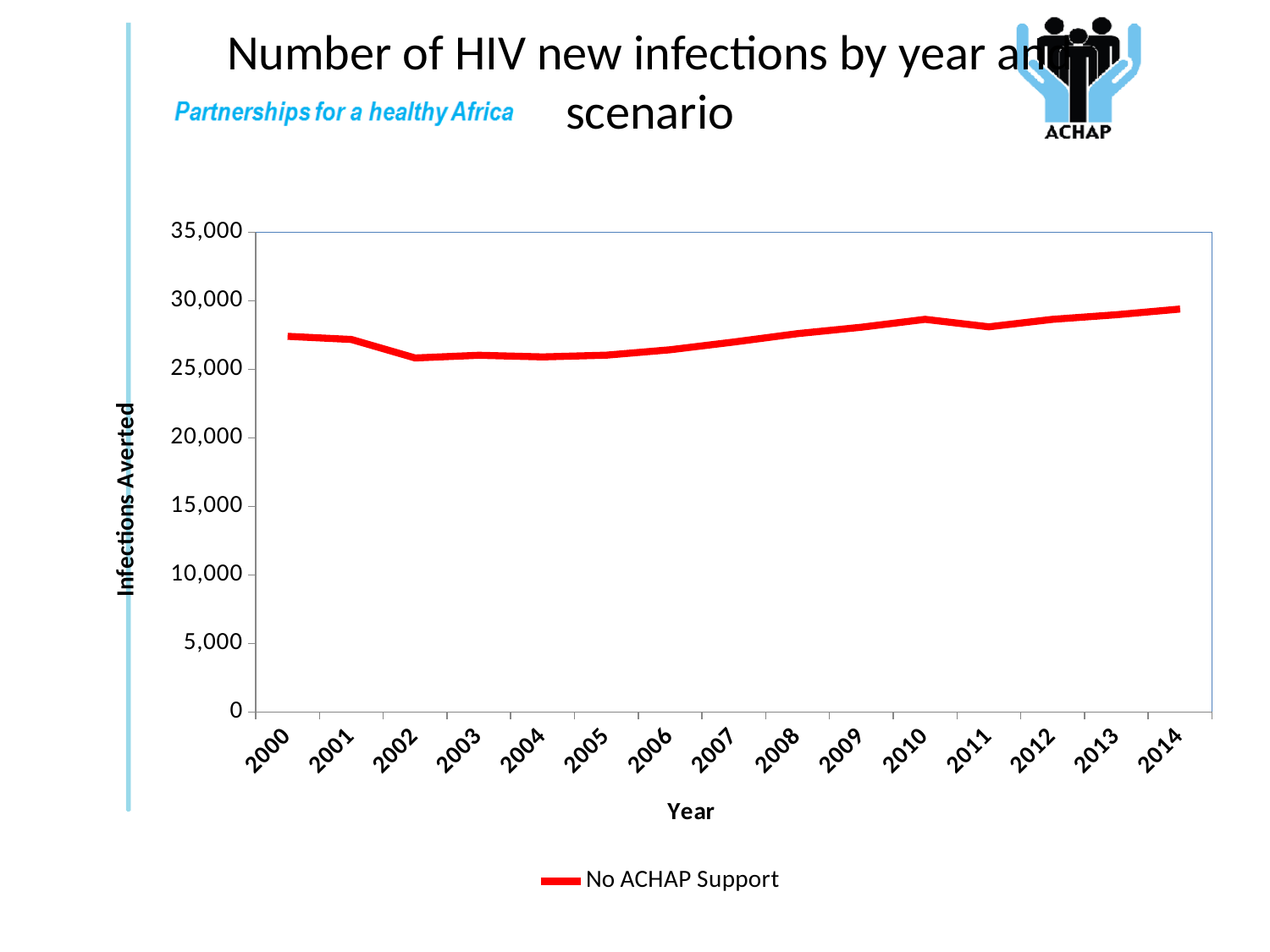
How many years are plotted along the x axis? 15 Which year has the highest value for No ACHAP Support? 2014 Is the value for 2000 greater or less than 25,000? greater What is the name of the series shown in the legend? No ACHAP Support Do the values rise or fall from 2002 to 2014? rise Is the value for 2010 greater or less than 25,000? greater What kind of chart is shown on the slide? line chart Is the value for 2005 greater or less than 30,000? less What is the label of the y axis? Infections Averted Which is larger, the value for 2000 or the value for 2014? 2014 How many series does the legend list? 1